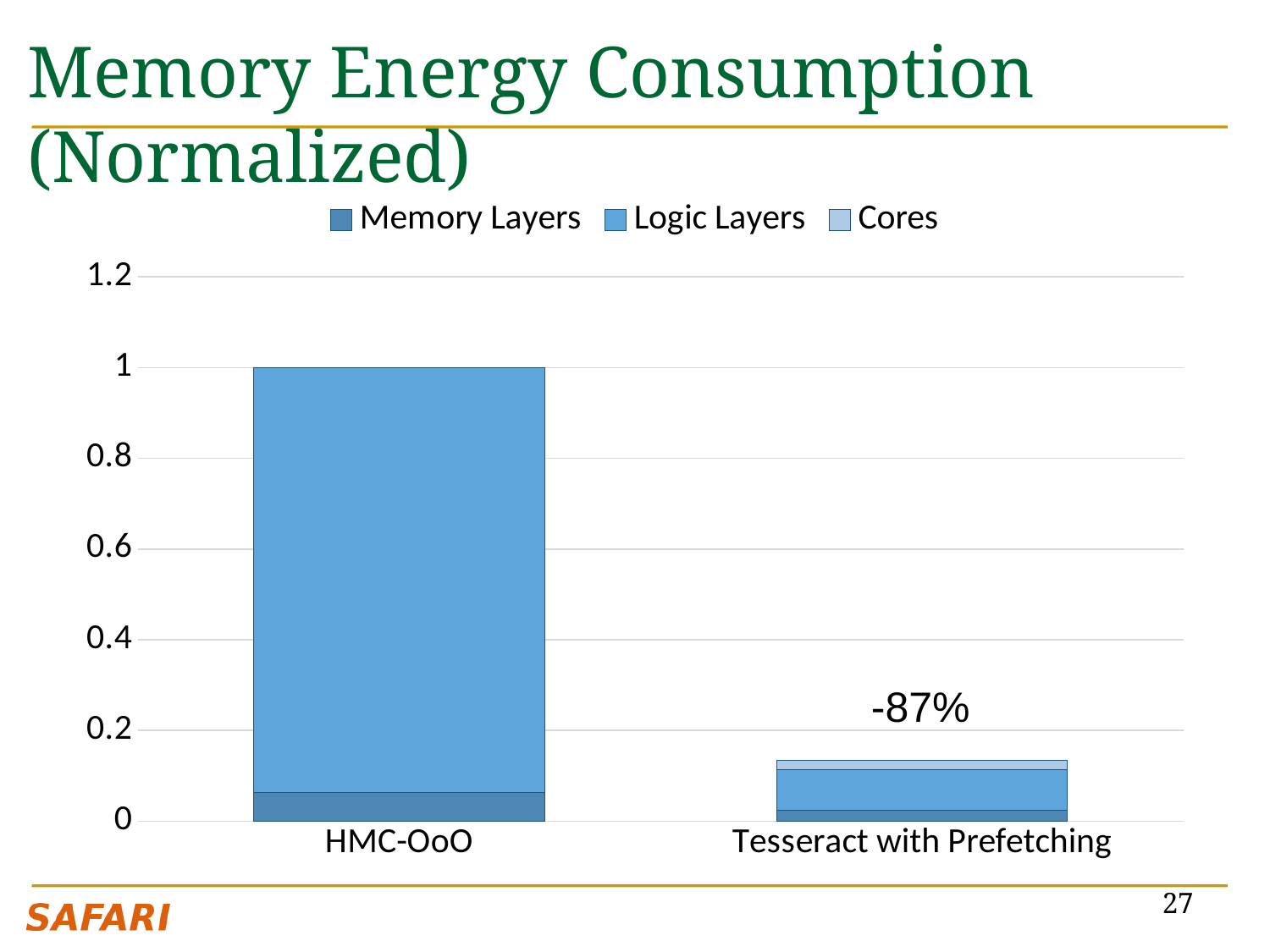
Do the bar totals rise or fall from left to right along the x axis? fall What kind of chart is shown on the slide? bar chart Which category has the lowest total memory energy consumption? Tesseract with Prefetching What is the total normalized memory energy consumption for HMC-OoO? 1 How many categories are shown on the x axis of the chart? 2 Which category has the highest total memory energy consumption? HMC-OoO Is the total value for Tesseract with Prefetching greater or less than 0.2? less What are the three series listed in the chart's legend? Memory Layers, Logic Layers, Cores Is the total value for HMC-OoO greater or less than 0.8? greater How many series does the chart's legend list? 3 Which has the larger total bar, HMC-OoO or Tesseract with Prefetching? HMC-OoO What label is printed above the Tesseract with Prefetching bar? -87%